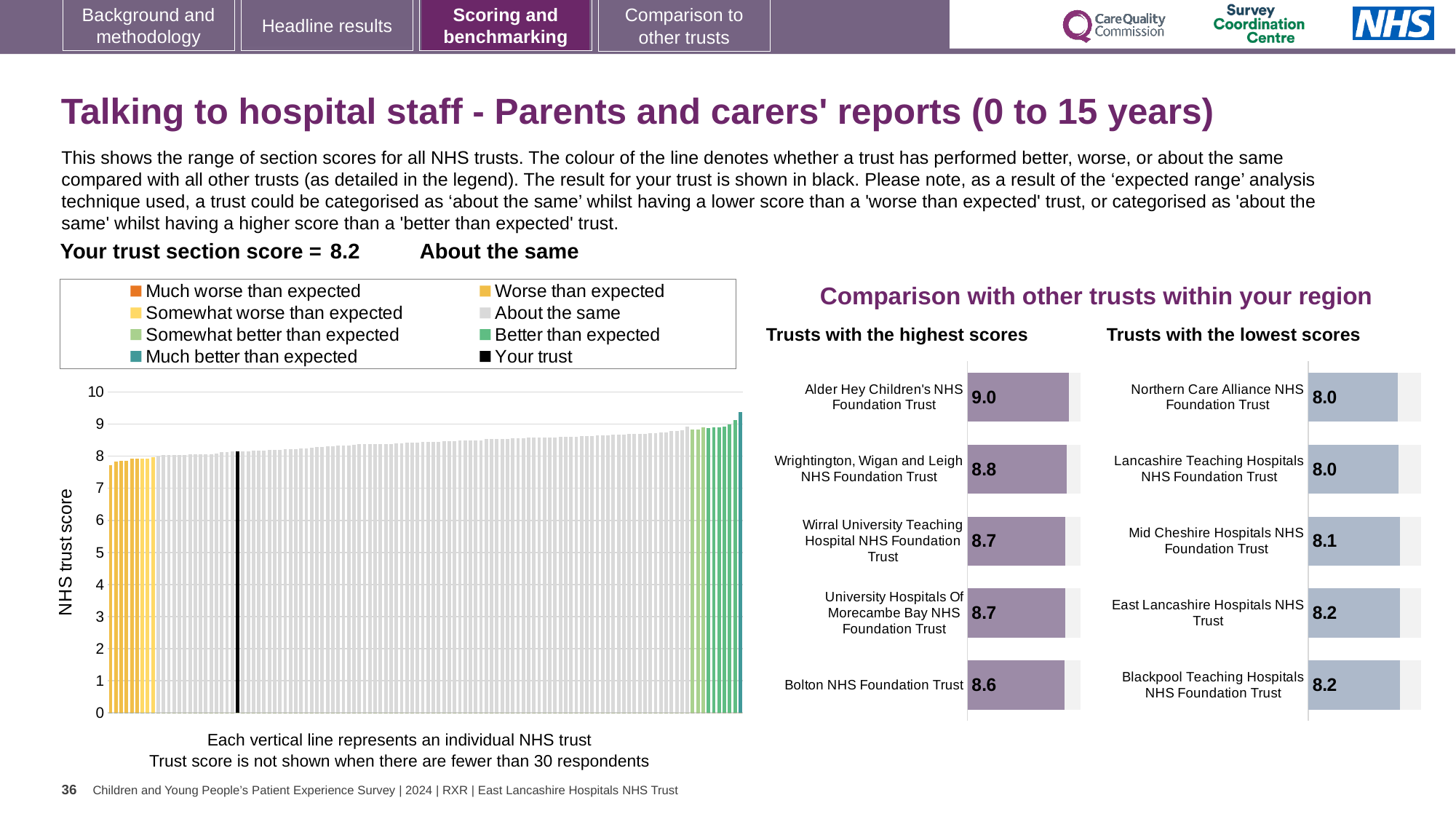
In the legend of the large chart on the left, what colour represents 'Your trust'? Black In the 'Trusts with the highest scores' chart, what is the score for Wrightington, Wigan and Leigh NHS Foundation Trust? 8.8 In the 'Trusts with the lowest scores' chart, how many trusts are shown? 5 In the large 'NHS trust score' chart on the left, do the bar values rise or fall from left to right? Rise In the large 'NHS trust score' chart on the left, is the value for the tallest bar greater or less than 9? greater In the 'Trusts with the highest scores' chart, what is the difference between the scores of Alder Hey Children's NHS Foundation Trust and Bolton NHS Foundation Trust? 0.4 What kind of chart is the large chart on the left with the 'NHS trust score' axis? Bar chart In the 'Trusts with the highest scores' chart, which trust has the highest score? Alder Hey Children's NHS Foundation Trust In the 'Trusts with the lowest scores' chart, what is the score for Mid Cheshire Hospitals NHS Foundation Trust? 8.1 In the 'Trusts with the highest scores' chart, which trust has the lowest score? Bolton NHS Foundation Trust In the 'Trusts with the highest scores' chart, what is the score for Alder Hey Children's NHS Foundation Trust? 9.0 In the 'Trusts with the lowest scores' chart, which has the larger score: Mid Cheshire Hospitals NHS Foundation Trust or Northern Care Alliance NHS Foundation Trust? Mid Cheshire Hospitals NHS Foundation Trust